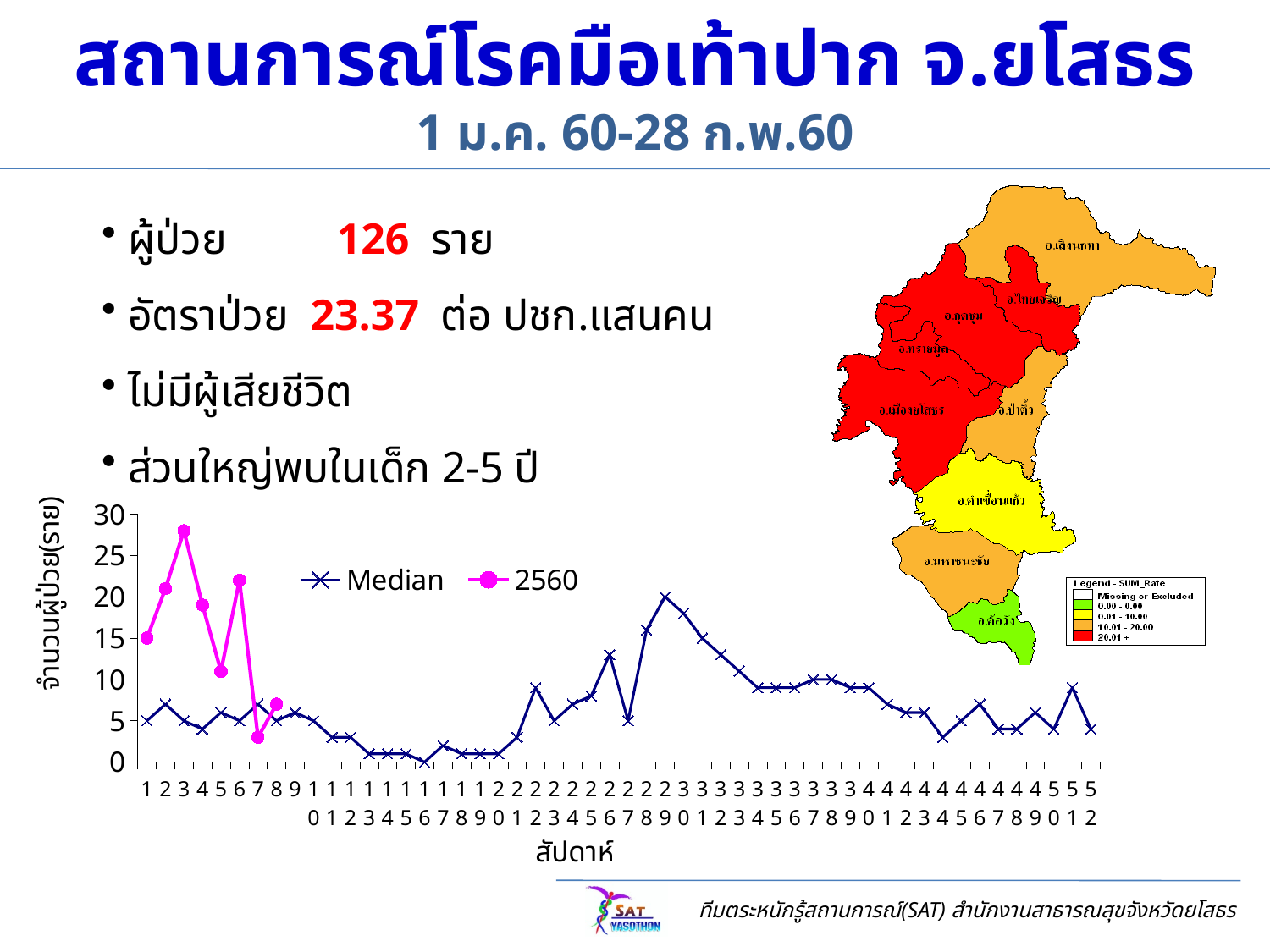
What is the x-axis title of the chart? สัปดาห์ Is the 2560 value for week 7 greater or less than 5? less In which week does the 2560 series have its lowest value? week 7 What kind of chart is shown on the slide? line chart In which week does the 2560 series reach its highest value? week 3 In week 3, which series has the larger value, Median or 2560? 2560 For the 2560 series, which is larger, the value for week 5 or the value for week 6? week 6 How many series does the chart legend list? 2 Is the Median value for week 1 greater or less than 10? less Is the 2560 value for week 1 greater or less than 10? greater What are the two series named in the chart legend? Median and 2560